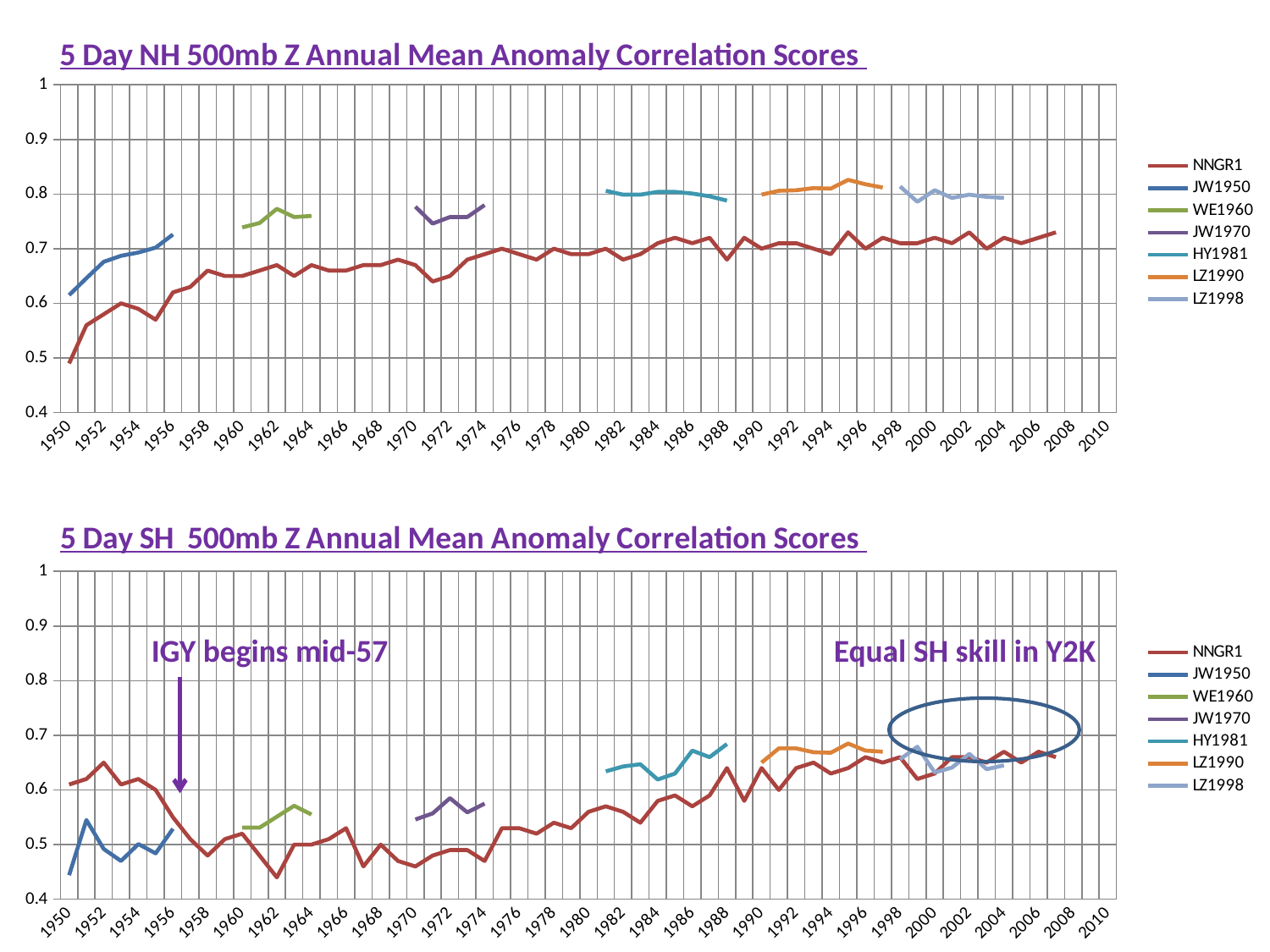
In the bottom (SH) chart, which series has the larger value in 1962, WE1960 or NNGR1? WE1960 In the top (NH) chart, which series has the larger value in 1992, LZ1990 or NNGR1? LZ1990 In the top (NH) chart, does the JW1950 series rise or fall from 1950 to 1956? rise How many series does the legend of the top (NH) chart list? 7 In the top (NH) chart, does the NNGR1 series rise or fall overall from 1950 to 2007? rise In the bottom (SH) chart, is the value of the LZ1990 series in 1992 greater or less than 0.7? less What is the title of the bottom chart? 5 Day SH 500mb Z Annual Mean Anomaly Correlation Scores What does the arrow annotation in the bottom (SH) chart say? IGY begins mid-57 In the bottom (SH) chart, is the value of the NNGR1 series in 1962 greater or less than 0.5? less In the top (NH) chart, is the value of the NNGR1 series in 1950 greater or less than 0.6? less What kind of chart is the top chart, '5 Day NH 500mb Z Annual Mean Anomaly Correlation Scores'? line chart